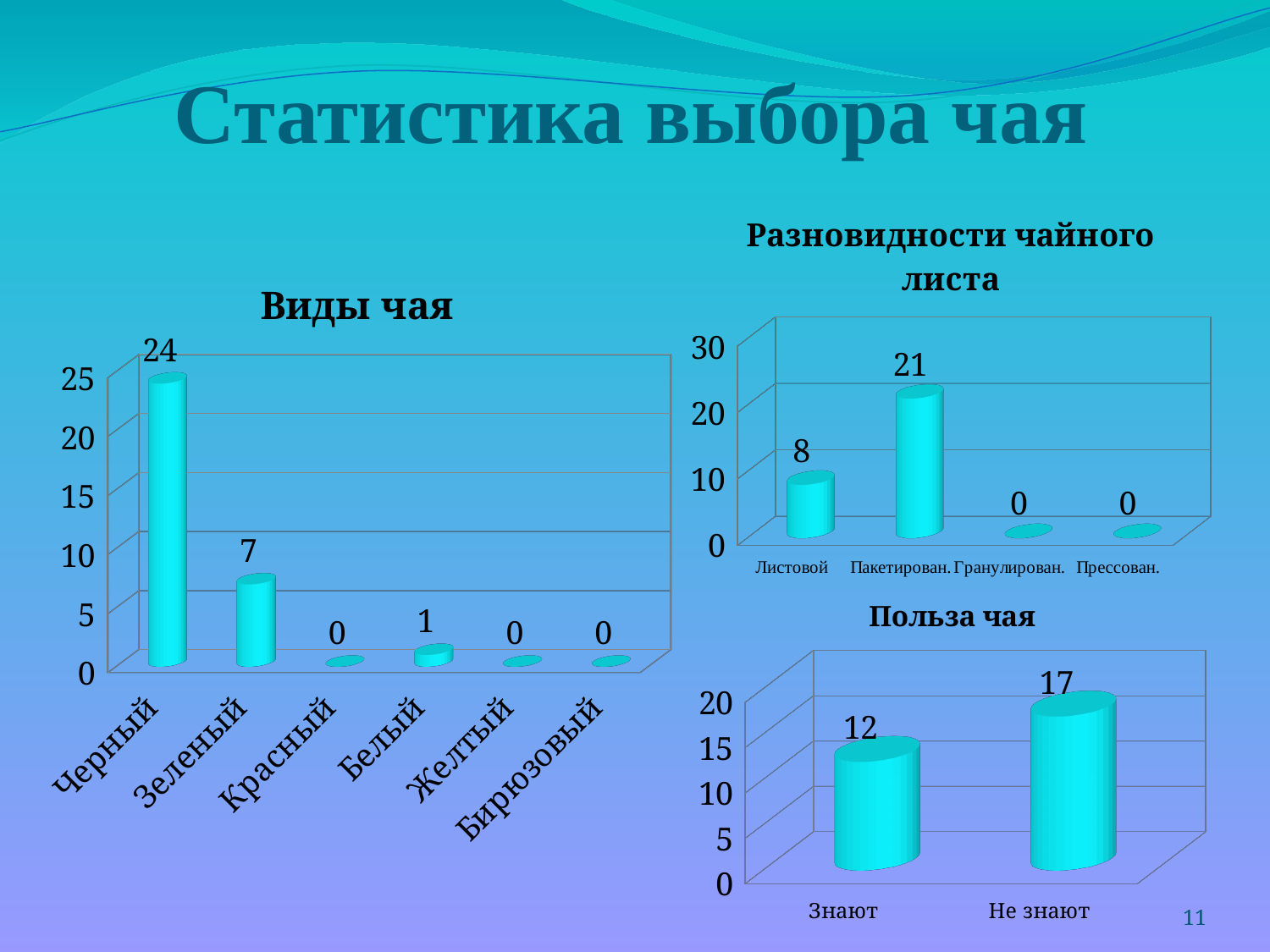
In the "Виды чая" chart, what is the value for Зеленый? 7 In the "Виды чая" chart, how many categories are shown on the x axis? 6 In the "Польза чая" chart, which is larger, Знают or Не знают? Не знают In the "Польза чая" chart, what is the value for Не знают? 17 What kind of chart is the "Польза чая" chart? Bar chart In the "Виды чая" chart, what is the value for Черный? 24 In the "Виды чая" chart, what is the difference between the values for Черный and Зеленый? 17 In the "Разновидности чайного листа" chart, what is the value for Листовой? 8 In the "Польза чая" chart, what is the difference between Не знают and Знают? 5 In the "Разновидности чайного листа" chart, which category has the highest value? Пакетирован. In the "Виды чая" chart, which category has the highest value? Черный In the "Разновидности чайного листа" chart, what is the value for Пакетирован.? 21